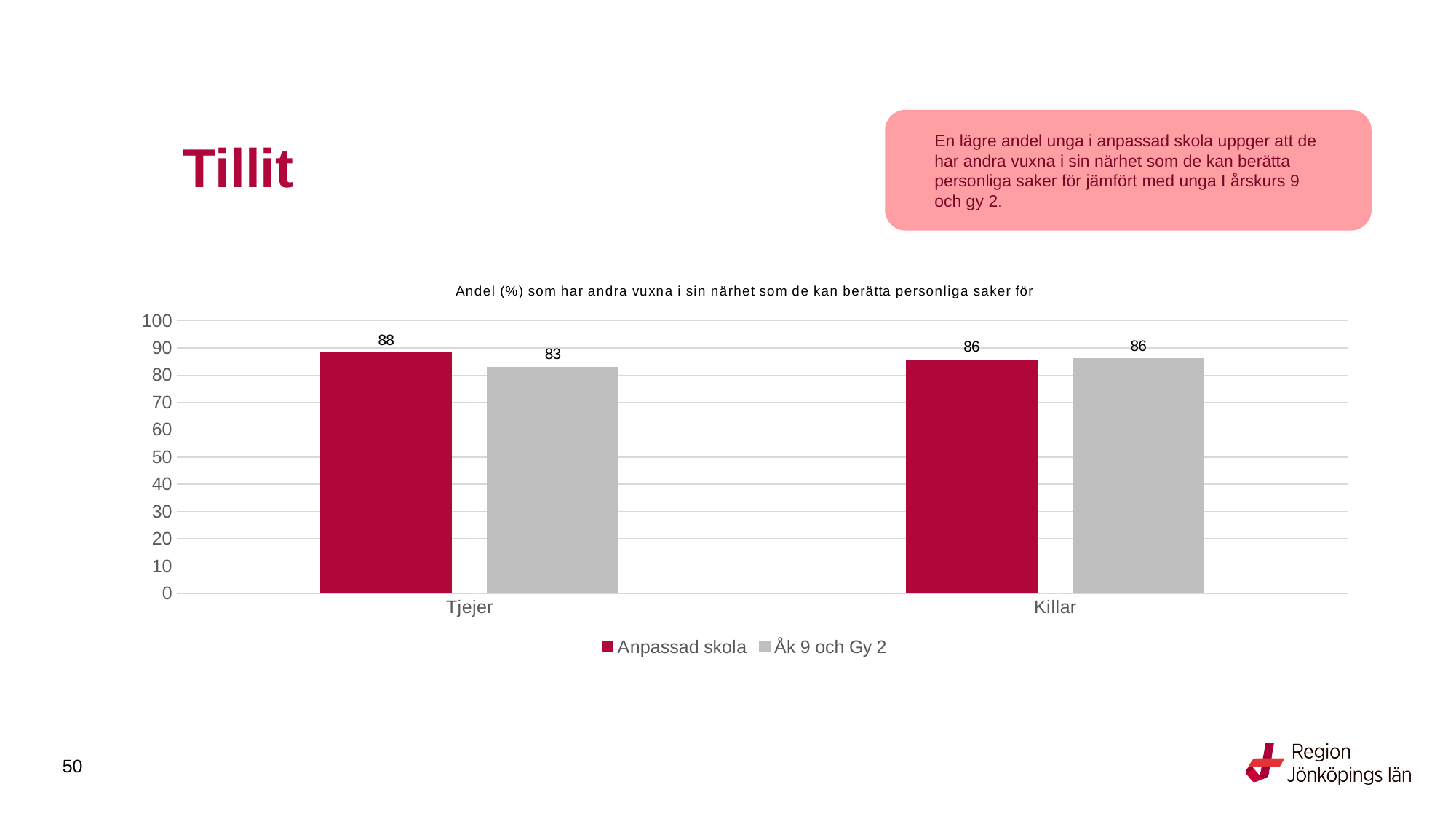
For Tjejer, which series has the larger value, Anpassad skola or Åk 9 och Gy 2? Anpassad skola What is the value for Åk 9 och Gy 2 in the Tjejer category? 83 What is the value for Åk 9 och Gy 2 in the Killar category? 86 How many series does the legend list? 2 What is the difference between Anpassad skola and Åk 9 och Gy 2 for Tjejer? 5 What is the value for Anpassad skola in the Killar category? 86 Which bar has the lowest value in the chart? Åk 9 och Gy 2, Tjejer What is the title of the chart? Andel (%) som har andra vuxna i sin närhet som de kan berätta personliga saker för How many categories are shown on the x axis? 2 Which bar has the highest value in the chart? Anpassad skola, Tjejer What kind of chart is shown on the slide? Bar chart What is the value for Anpassad skola in the Tjejer category? 88